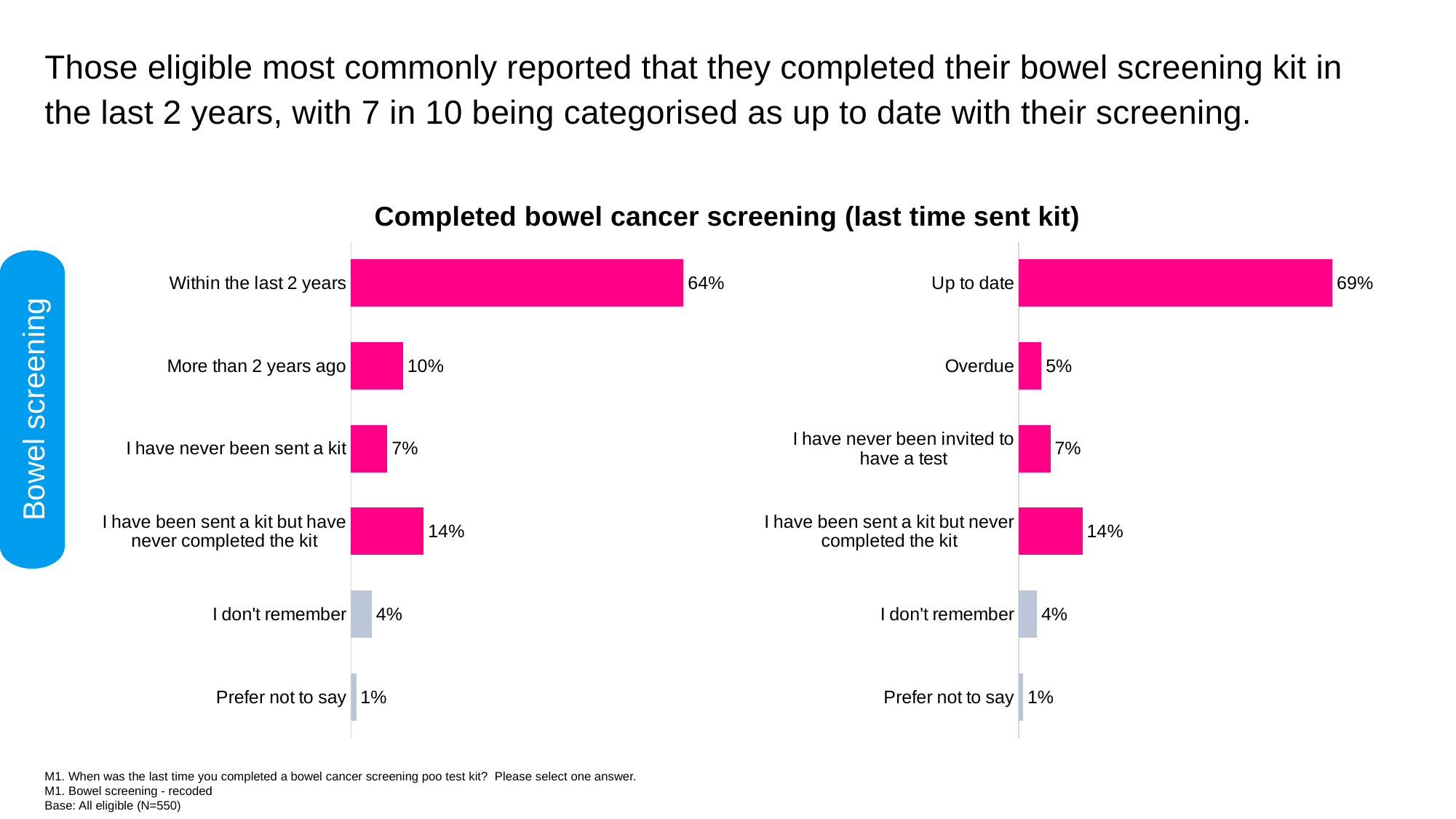
What is the title shown above the charts? Completed bowel cancer screening (last time sent kit) In the left chart, what is the difference between 'Within the last 2 years' and 'I have been sent a kit but have never completed the kit'? 50% In the right chart, which category has the highest value? Up to date In the right chart, what percentage are categorised as up to date? 69% In the left chart, what is the value for 'More than 2 years ago'? 10% In the left chart, which category has the lowest value? Prefer not to say In the left chart, which is larger: 'More than 2 years ago' or 'I have never been sent a kit'? More than 2 years ago In the left chart, what percentage reported completing their kit within the last 2 years? 64% How many categories are shown in the right chart? 6 In the right chart, what is the difference between 'Up to date' and 'Overdue'? 64% What type of chart is the left chart? Bar chart In the right chart, what is the value for 'Overdue'? 5%